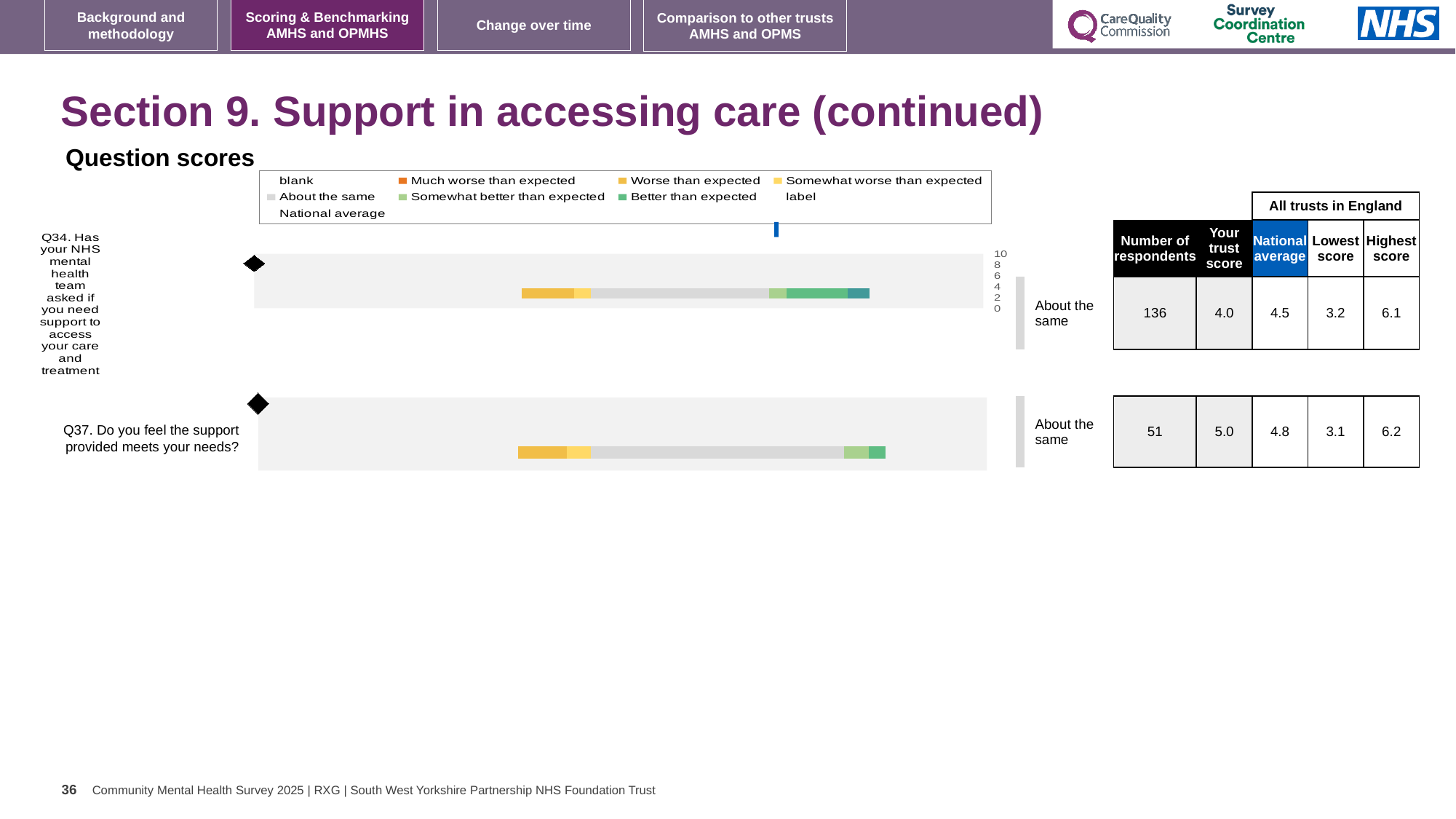
What benchmark category is shown for Q37? About the same Which legend entry is shown in orange? Much worse than expected How many questions are plotted in the question scores chart? 2 What kind of chart is used to show the question scores for Q34 and Q37? Bar chart How many respondents answered Q37? 51 Which question has the higher trust score, Q34 or Q37? Q37 What is the trust score for Q34 (Has your NHS mental health team asked if you need support to access your care and treatment)? 4.0 What is the trust score for Q37 (Do you feel the support provided meets your needs)? 5.0 What is the difference between the highest score and the lowest score for Q34? 2.9 What is the national average score for Q34? 4.5 What is the highest score among all trusts in England for Q37? 6.2 Is the trust score for Q34 higher or lower than the national average for Q34? Lower